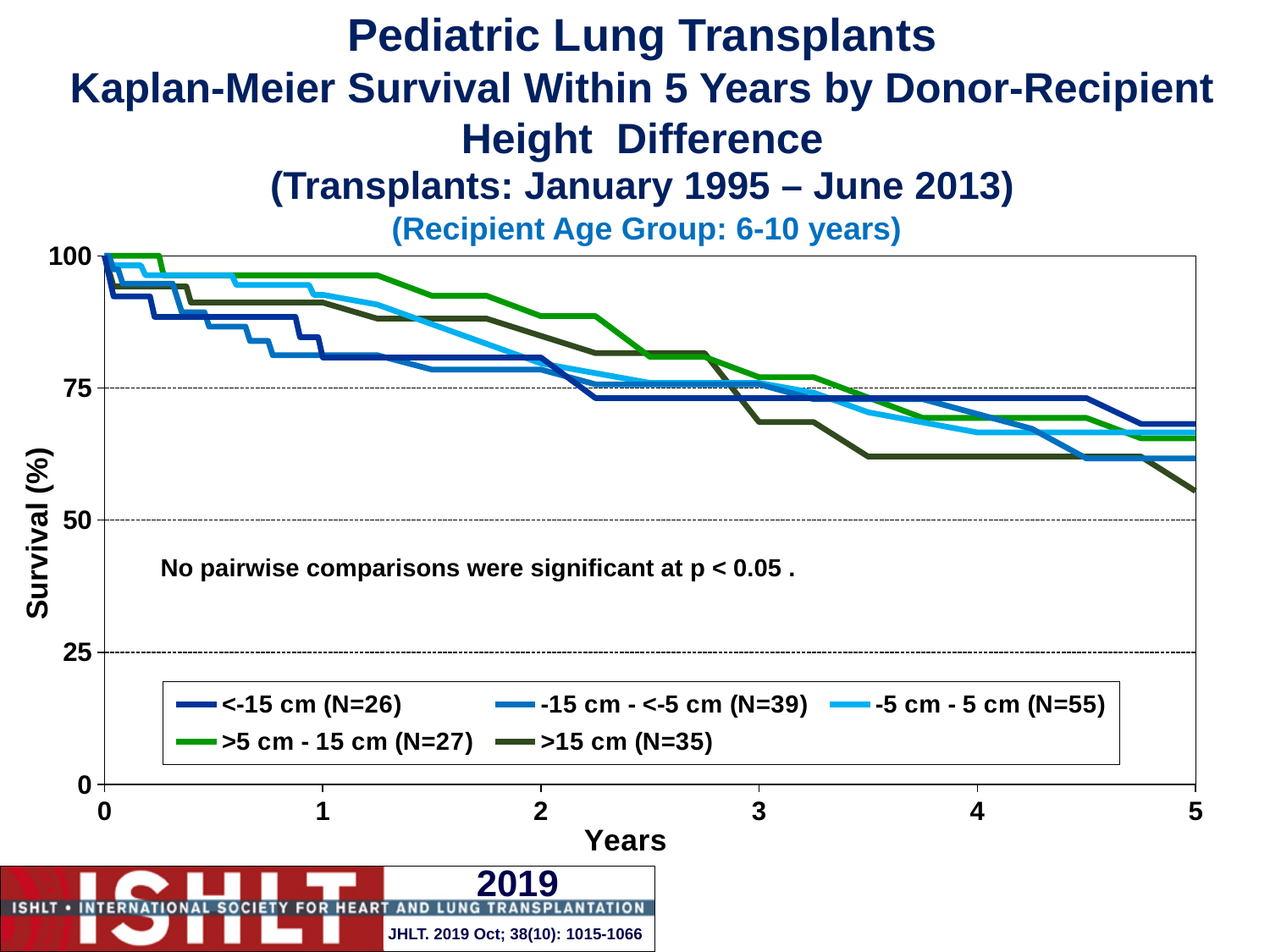
At 1 year, is the survival value for the >5 cm - 15 cm (N=27) group greater or less than 75? greater Which group has the lowest survival at 5 years? >15 cm (N=35) At 5 years, which has the higher survival: the <-15 cm (N=26) group or the >15 cm (N=35) group? <-15 cm (N=26) Do the survival curves rise or fall as the years increase along the x axis? Fall At 5 years, is the survival value for the <-15 cm (N=26) group greater or less than 75? less At 5 years, is the survival value for the >15 cm (N=35) group greater or less than 75? less What kind of chart is shown on the slide? Line chart What is the N for the -5 cm - 5 cm group in the legend? N=55 How many series does the legend list? 5 What is the recipient age group stated in the chart title? 6-10 years